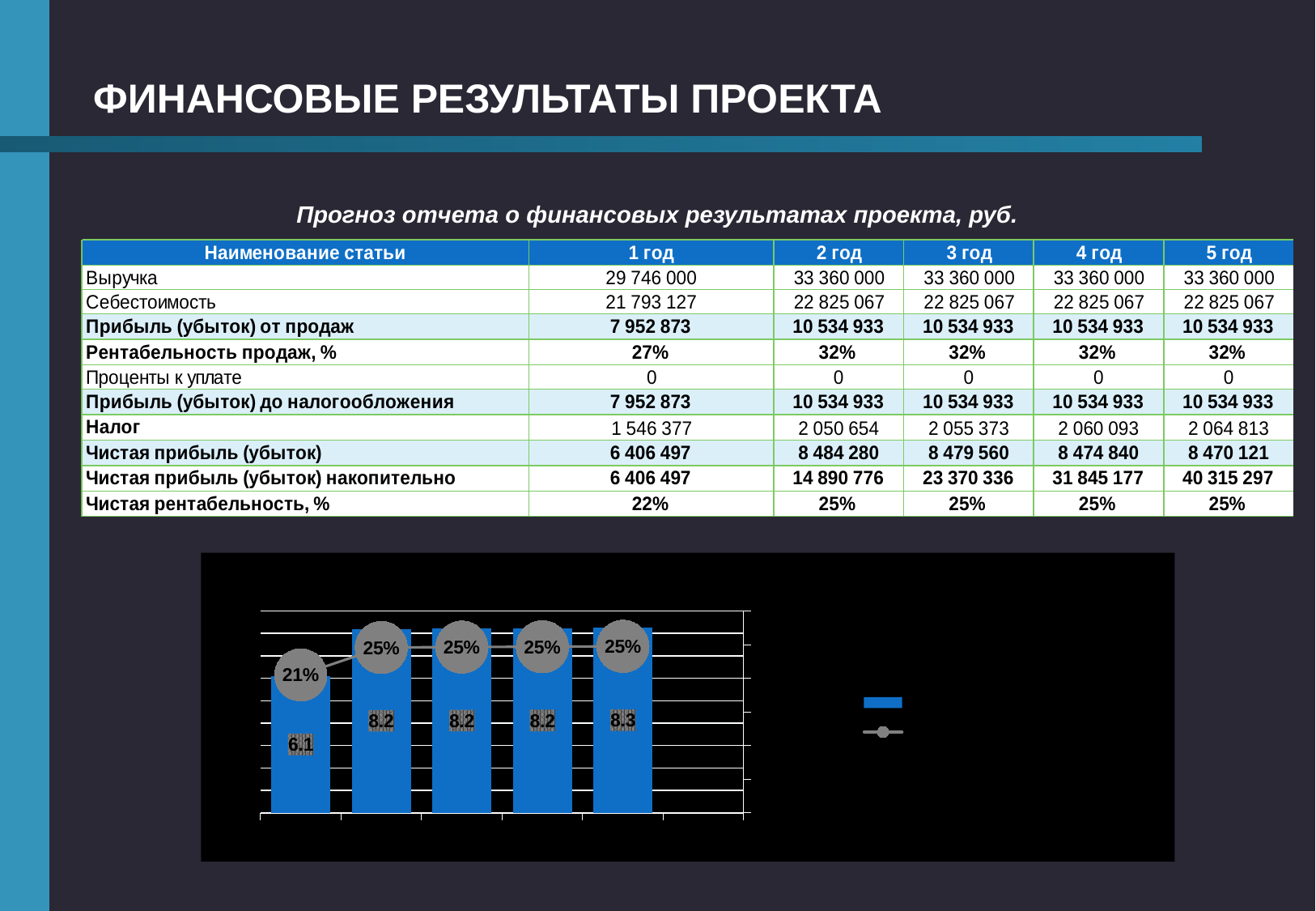
What is the data label on the rightmost bar in the chart? 8.3 What is the data label on the second bar from the left in the chart? 8.2 Which bar in the chart has the highest value? the rightmost bar What percentage is shown on the leftmost point of the line series in the chart? 21% Which bar in the chart has the lowest value? the leftmost bar How many series does the chart's legend list? 2 What percentage is shown on the rightmost point of the line series in the chart? 25% What is the difference between the rightmost bar's value and the leftmost bar's value in the chart? 2.2 How many bars are plotted in the chart? 5 Do the bar values in the chart generally rise or fall from left to right? rise What is the data label on the leftmost bar in the chart? 6.1 What type of chart is shown at the bottom of the slide? combined bar and line chart